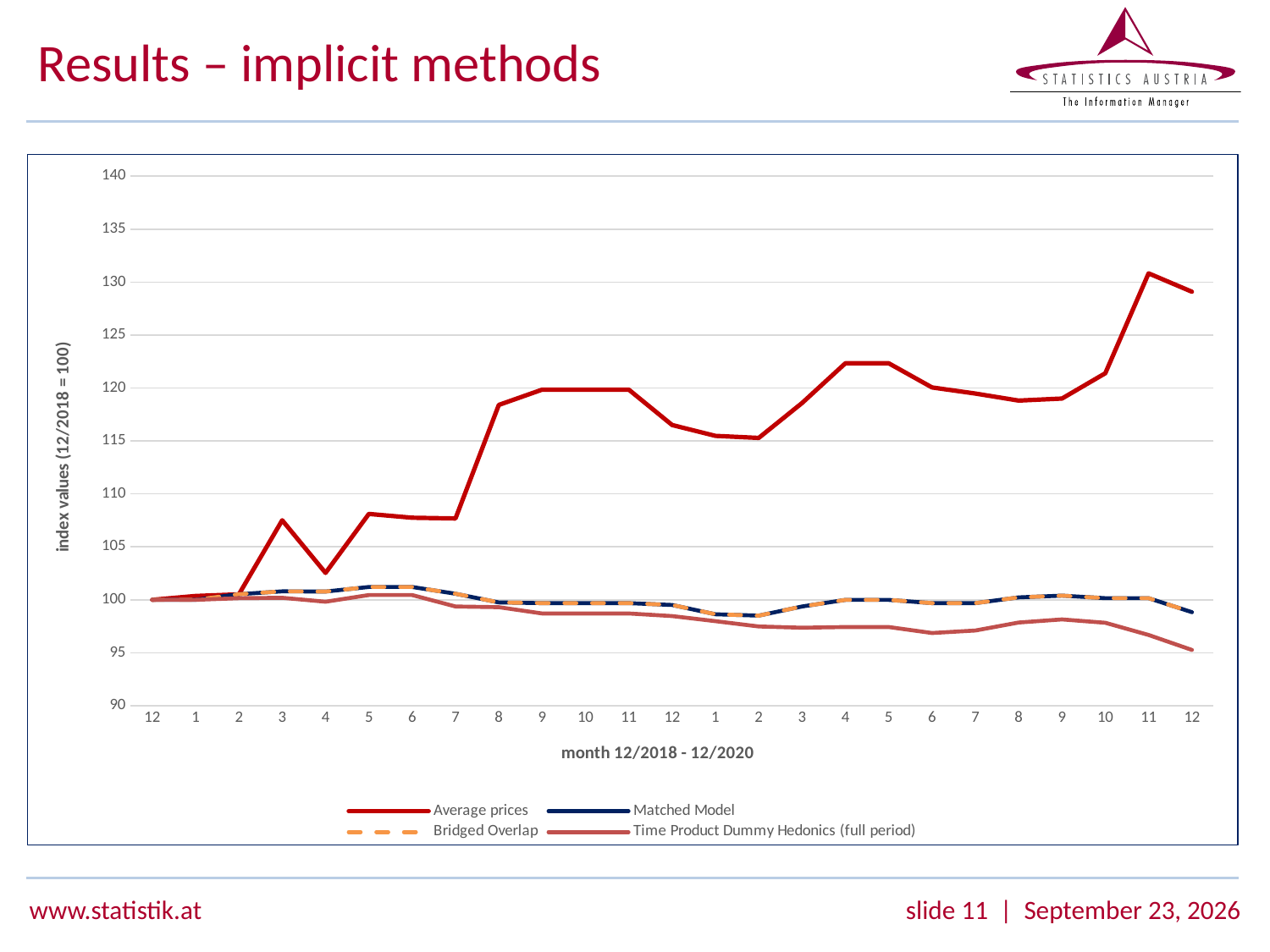
Which series is drawn with a dashed line? Bridged Overlap How many series does the legend list? 4 Do the Average prices values overall rise or fall from 12/2018 to 12/2020? rise Is the value of Average prices at month 8 of 2019 greater or less than 115? greater Is the value of Average prices at month 11 of 2020 greater or less than 125? greater How many monthly points are plotted along the x axis? 25 Is the value of Time Product Dummy Hedonics (full period) at the final month (12/2020) greater or less than 100? less What kind of chart is shown on the slide? line chart What is the label of the y axis? index values (12/2018 = 100) Which series has the highest value at the final month (12/2020)? Average prices Does the Time Product Dummy Hedonics (full period) series overall rise or fall from 12/2018 to 12/2020? fall Which series has the lowest value at the final month (12/2020)? Time Product Dummy Hedonics (full period)